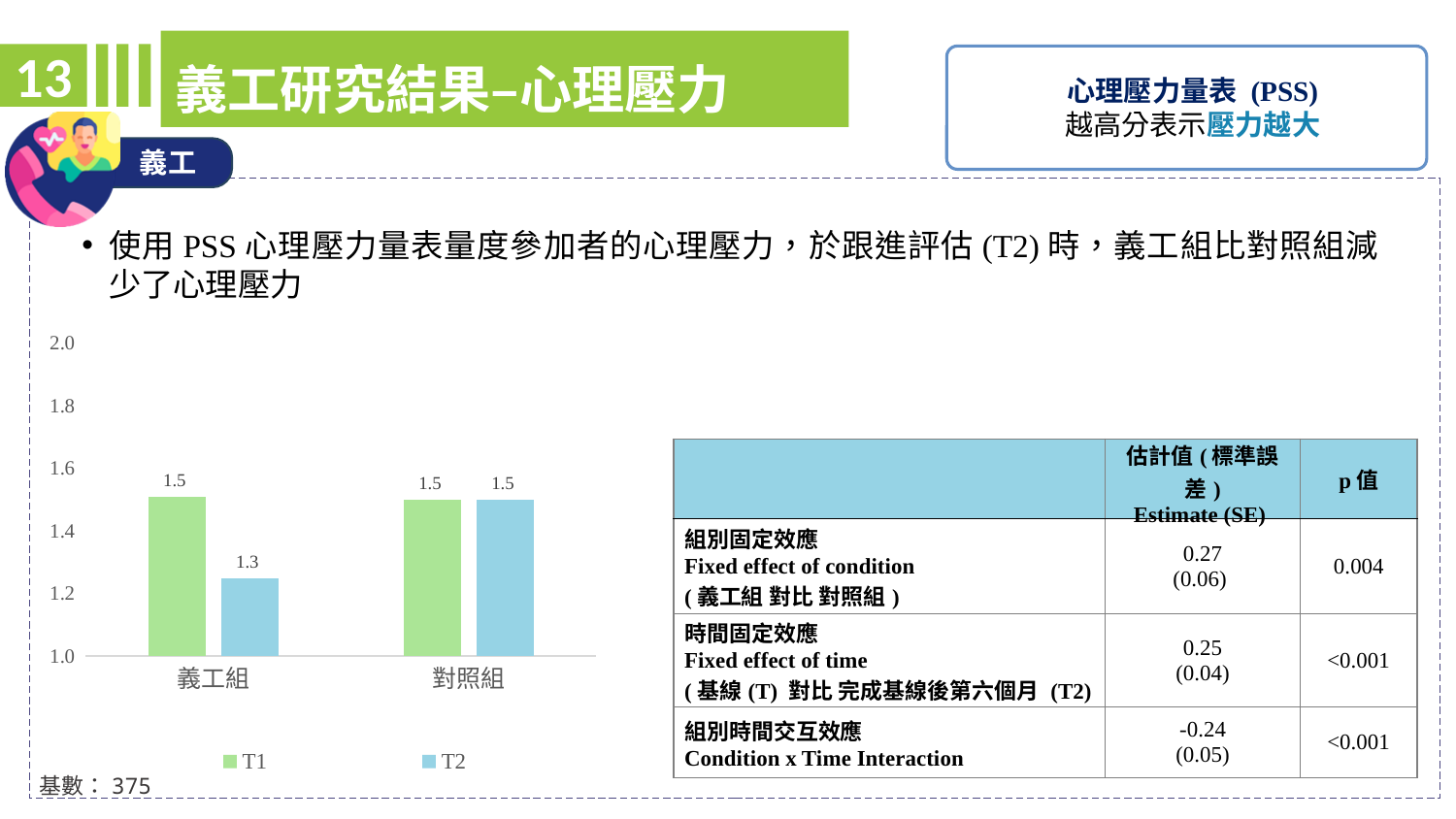
What is the T2 value for 義工組 in the bar chart? 1.3 From T1 to T2, does the value for 義工組 rise or fall? fall How many categories are shown on the x axis of the bar chart? 2 Which bar in the chart has the lowest value? 義工組 T2 How many series does the chart legend list? 2 What is the T1 value for 義工組 in the bar chart? 1.5 What kind of chart is shown on the slide? bar chart Which is larger: the T2 value for 義工組 or the T2 value for 對照組? 對照組 What is the difference between the T1 and T2 values for 義工組? 0.2 Is the T2 value for 義工組 greater or less than 1.4? less What is the T2 value for 對照組 in the bar chart? 1.5 What are the two series names listed in the chart legend? T1 and T2